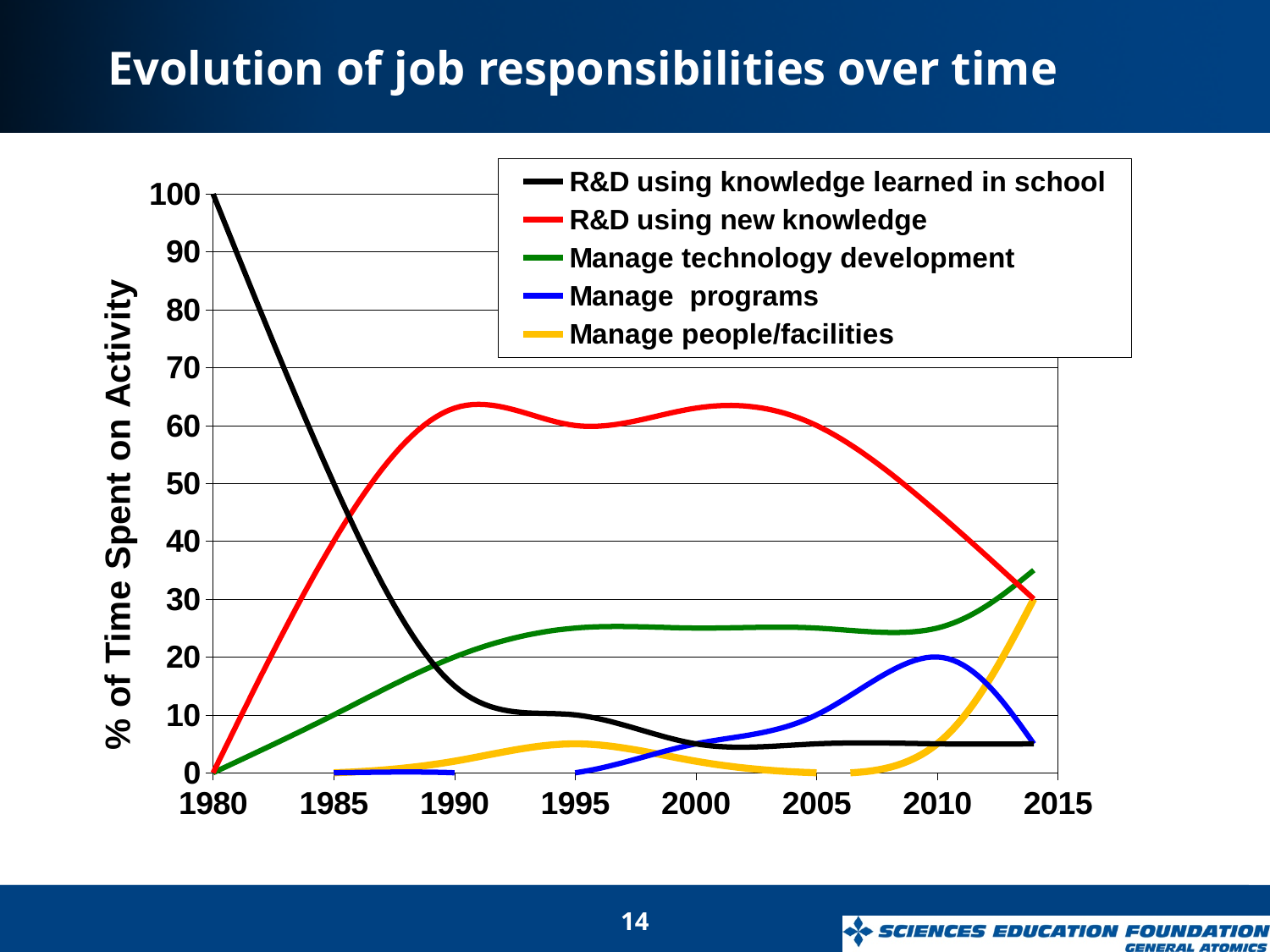
Is the value for 'R&D using new knowledge' in 2000 greater or less than 50? greater What is the value for 'R&D using knowledge learned in school' in 1980? 100 Does the 'R&D using knowledge learned in school' line rise or fall from 1980 to 1990? fall Is the value for 'Manage technology development' in 2005 greater or less than 20? greater What is the label on the y axis? % of Time Spent on Activity Is the value for 'Manage programs' in 2010 greater or less than 30? less What kind of chart is shown on the slide? line chart In 2000, which is larger: 'R&D using new knowledge' or 'Manage technology development'? R&D using new knowledge How many series does the legend list? 5 Which series has the highest value in 1980? R&D using knowledge learned in school What is the value for 'R&D using new knowledge' in 1980? 0